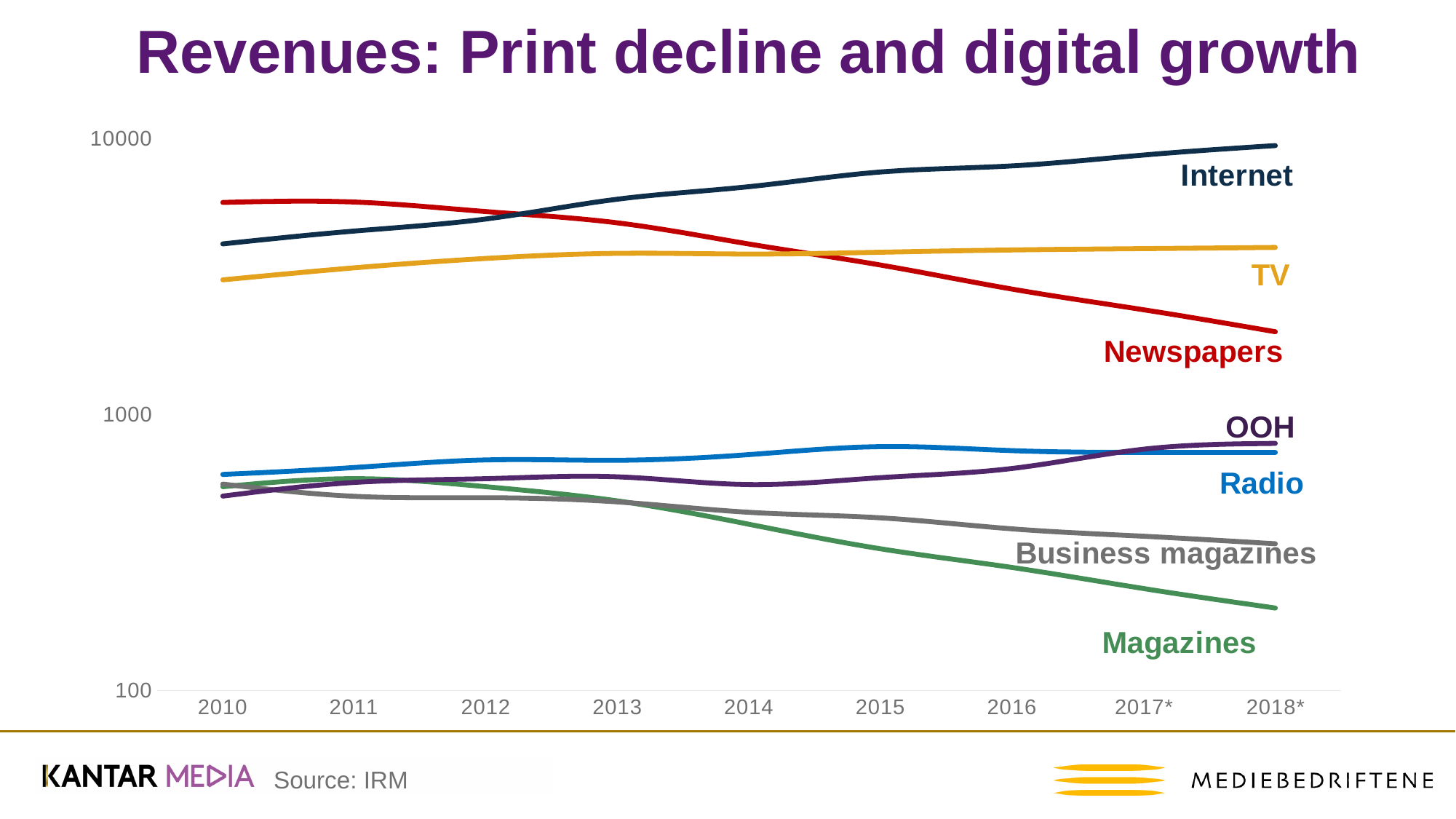
What is the title of the chart on the slide? Revenues: Print decline and digital growth What kind of chart is shown on the slide? line chart In 2010, which is larger: the value for Internet or the value for Newspapers? Newspapers In 2018*, which is larger: the value for TV or the value for Newspapers? TV Which series has the highest value in 2010? Newspapers Does the Internet series rise or fall from 2010 to 2018*? rise How many years are shown along the x axis of the chart? 9 How many series are plotted in the chart? 7 Is the value for Magazines in 2018* greater or less than 1000? less Which series has the lowest value in 2018*? Magazines Which series has the highest value in 2018*? Internet Is the value for Newspapers in 2018* greater or less than 1000? greater